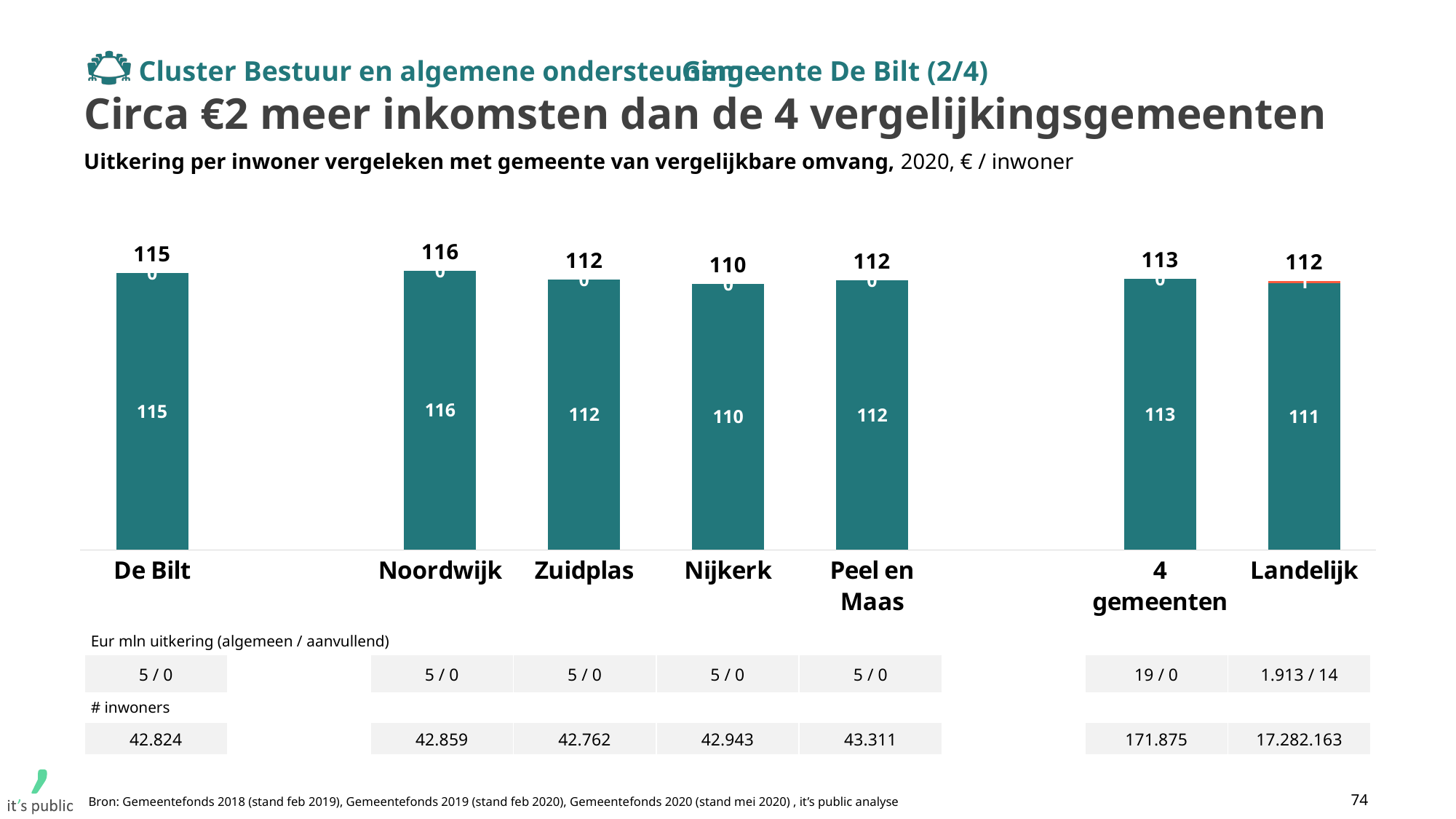
How many categories (bars) are shown in the chart? 7 Which category has the highest total value? Noordwijk What is the total value shown above the bar for De Bilt? 115 What is the difference between the total for De Bilt and the total for 4 gemeenten? 2 What is the total value shown above the bar for Noordwijk? 116 What is the value of the lower (teal) segment of the Landelijk bar? 111 Which category has the lowest total value? Nijkerk What is the total value shown above the bar for Nijkerk? 110 Which has a larger total value, De Bilt or Zuidplas? De Bilt What is the difference between the total for Noordwijk and the total for Nijkerk? 6 What is the total value shown above the bar for 4 gemeenten? 113 What kind of chart is shown on the slide? Bar chart